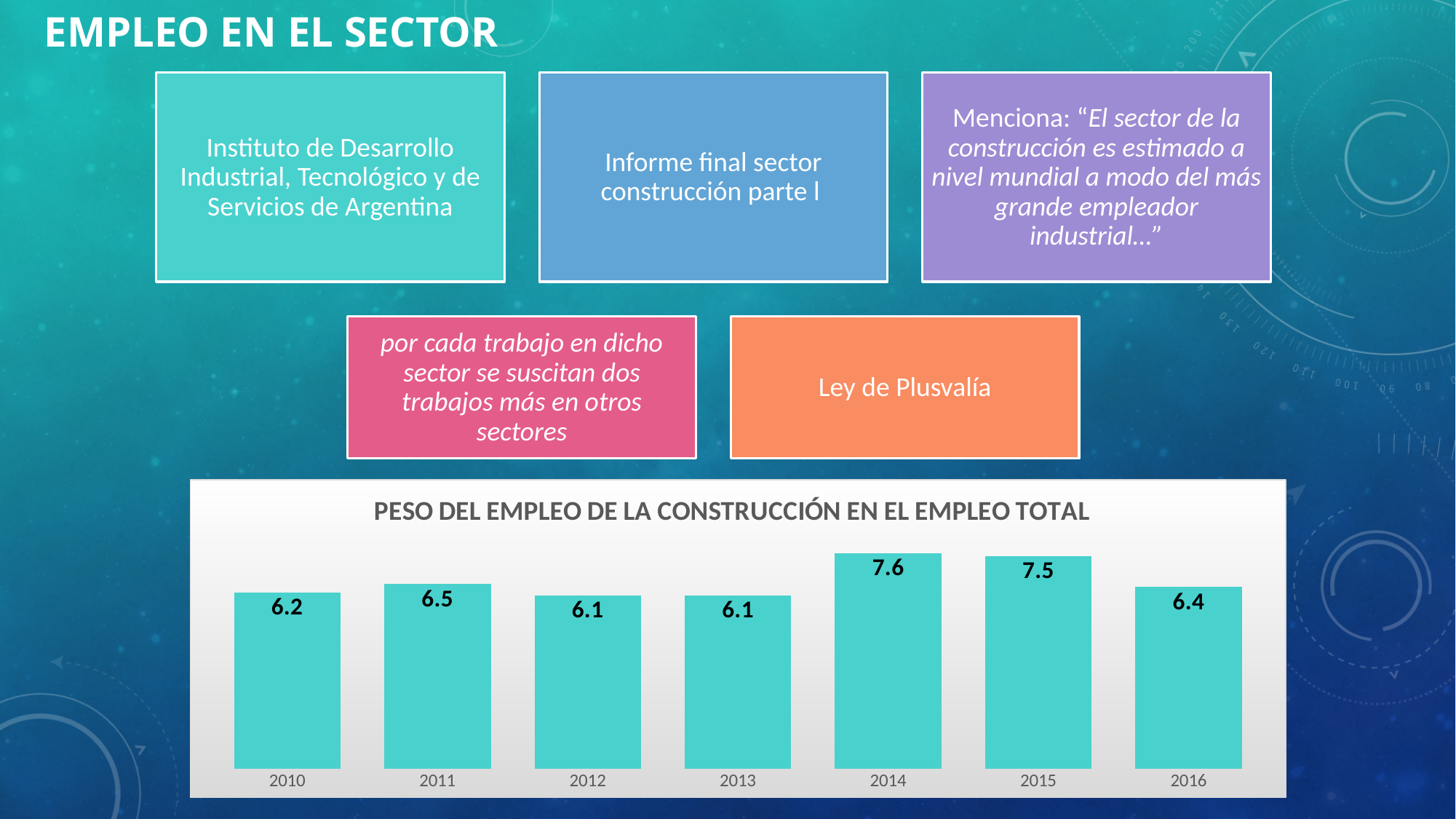
Which two years share the same value of 6.1? 2012 and 2013 What is the difference between the values for 2015 and 2016? 1.1 Which is larger, the value for 2011 or the value for 2012? 2011 Which year has the highest value? 2014 Do the values rise or fall from 2014 to 2016? fall How many years are shown on the chart? 7 What is the value for 2010? 6.2 What is the value for 2016? 6.4 What is the value for 2014? 7.6 What is the difference between the values for 2014 and 2010? 1.4 What is the title of the chart? PESO DEL EMPLEO DE LA CONSTRUCCIÓN EN EL EMPLEO TOTAL What kind of chart is shown on the slide? bar chart